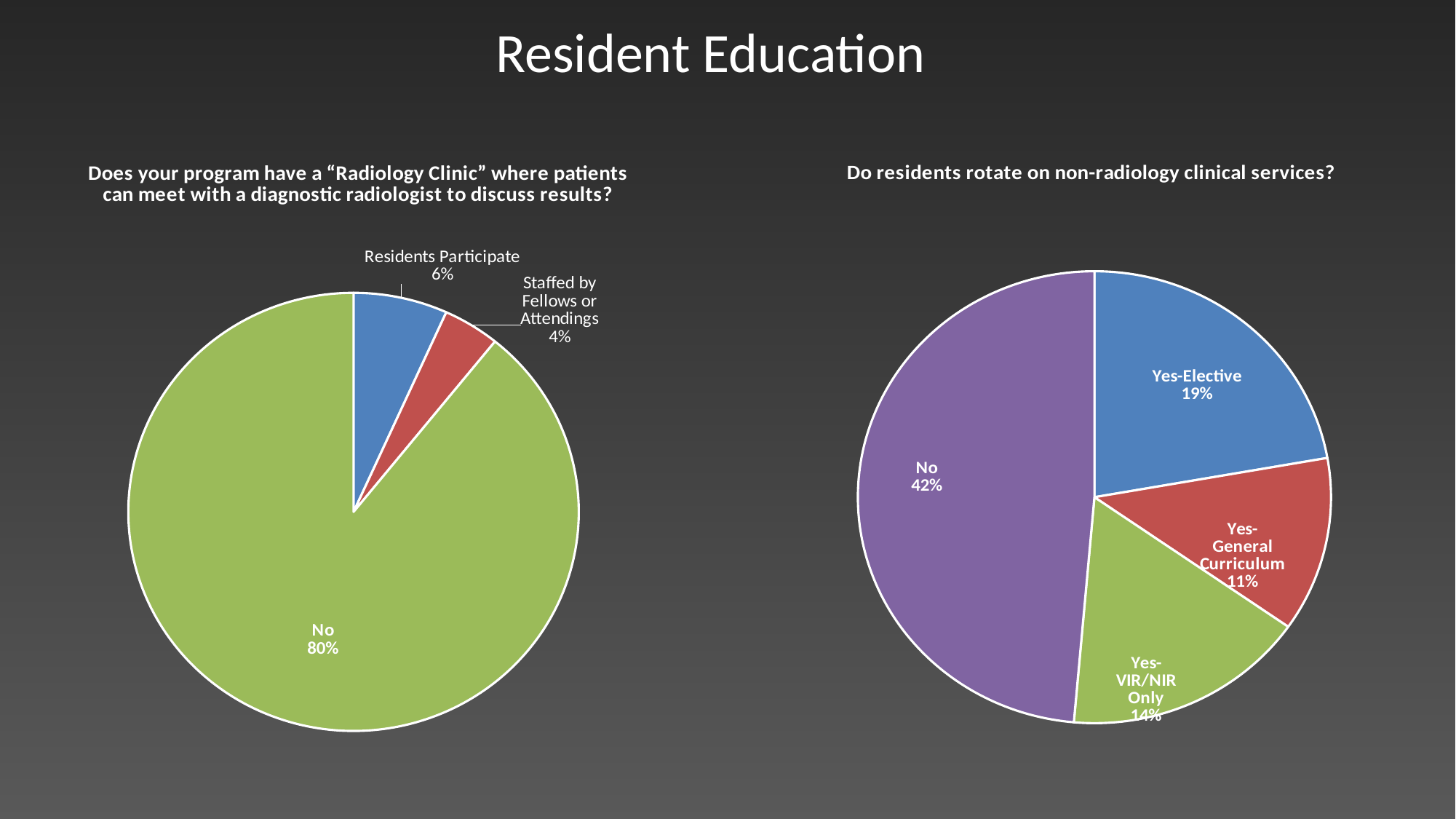
In the right pie chart (non-radiology clinical services), what is the difference between the "No" share and the "Yes-Elective" share? 23% In the right pie chart (non-radiology clinical services), which slice is the largest? No In the right pie chart (non-radiology clinical services), what share is labelled "Yes-Elective"? 19% In the right pie chart (non-radiology clinical services), what share is labelled "Yes-VIR/NIR Only"? 14% What kind of chart is used on the right side of the slide? Pie chart In the right pie chart (non-radiology clinical services), what share is labelled "Yes-General Curriculum"? 11% In the left pie chart (Radiology Clinic), which slice is the largest? No In the left pie chart (Radiology Clinic), what share is labelled "Residents Participate"? 6% In the left pie chart (Radiology Clinic), what share is labelled "No"? 80% In the left pie chart (Radiology Clinic), how many slices does the pie have? 3 In the left pie chart (Radiology Clinic), what share is labelled "Staffed by Fellows or Attendings"? 4% In the left pie chart (Radiology Clinic), which slice is the smallest? Staffed by Fellows or Attendings